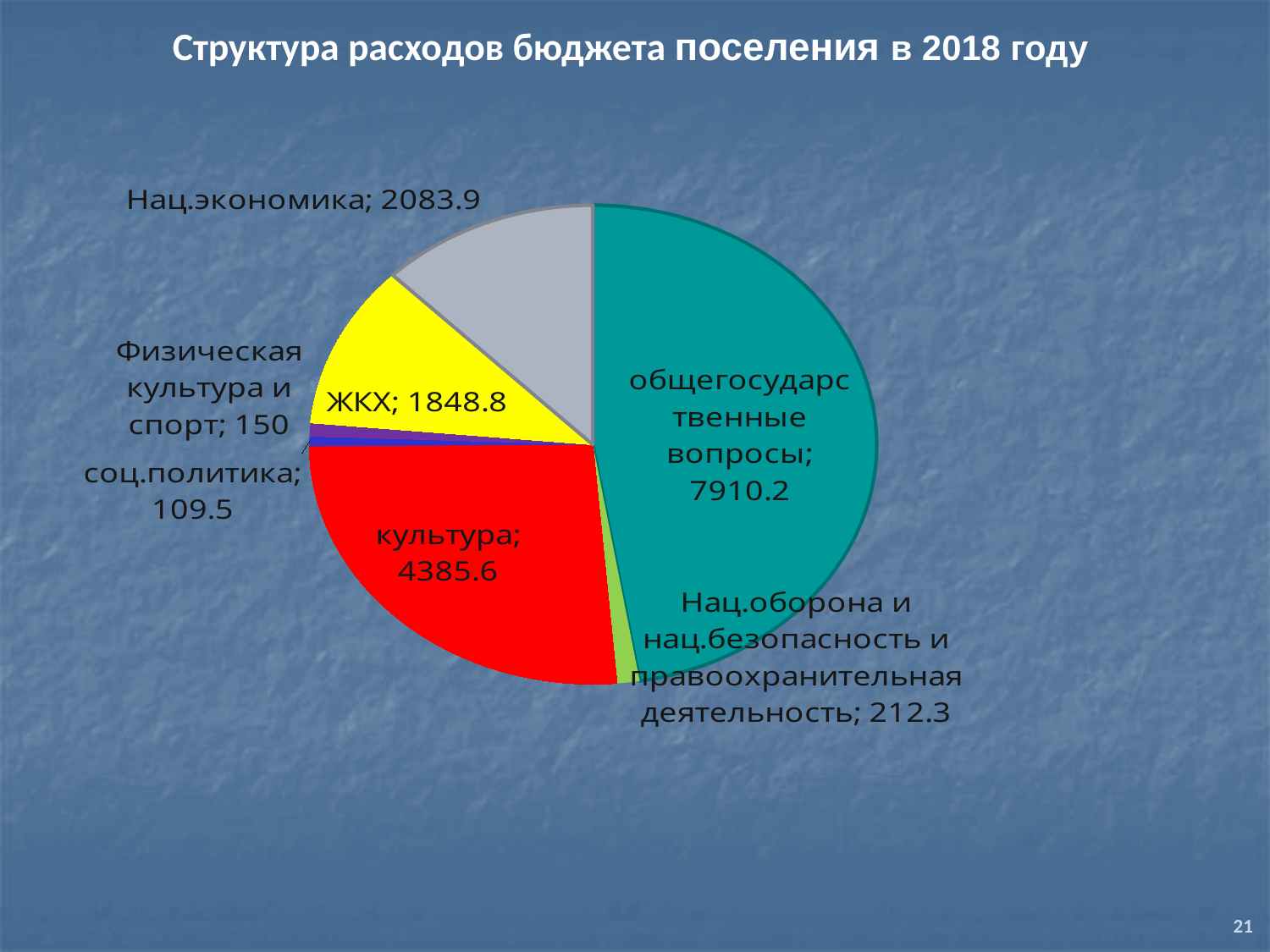
What kind of chart is shown on the slide? pie chart What is the value for соц.политика? 109.5 What colour is the slice for культура? red What is the value for ЖКХ? 1848.8 What is the value for общегосударственные вопросы? 7910.2 What is the value for культура? 4385.6 What is the title of the chart? Структура расходов бюджета поселения в 2018 году Which category has the smallest value? соц.политика Which is larger, Нац.экономика or ЖКХ? Нац.экономика Which category has the largest value? общегосударственные вопросы What is the difference between общегосударственные вопросы and культура? 3524.6 How many slices does the pie chart have? 7